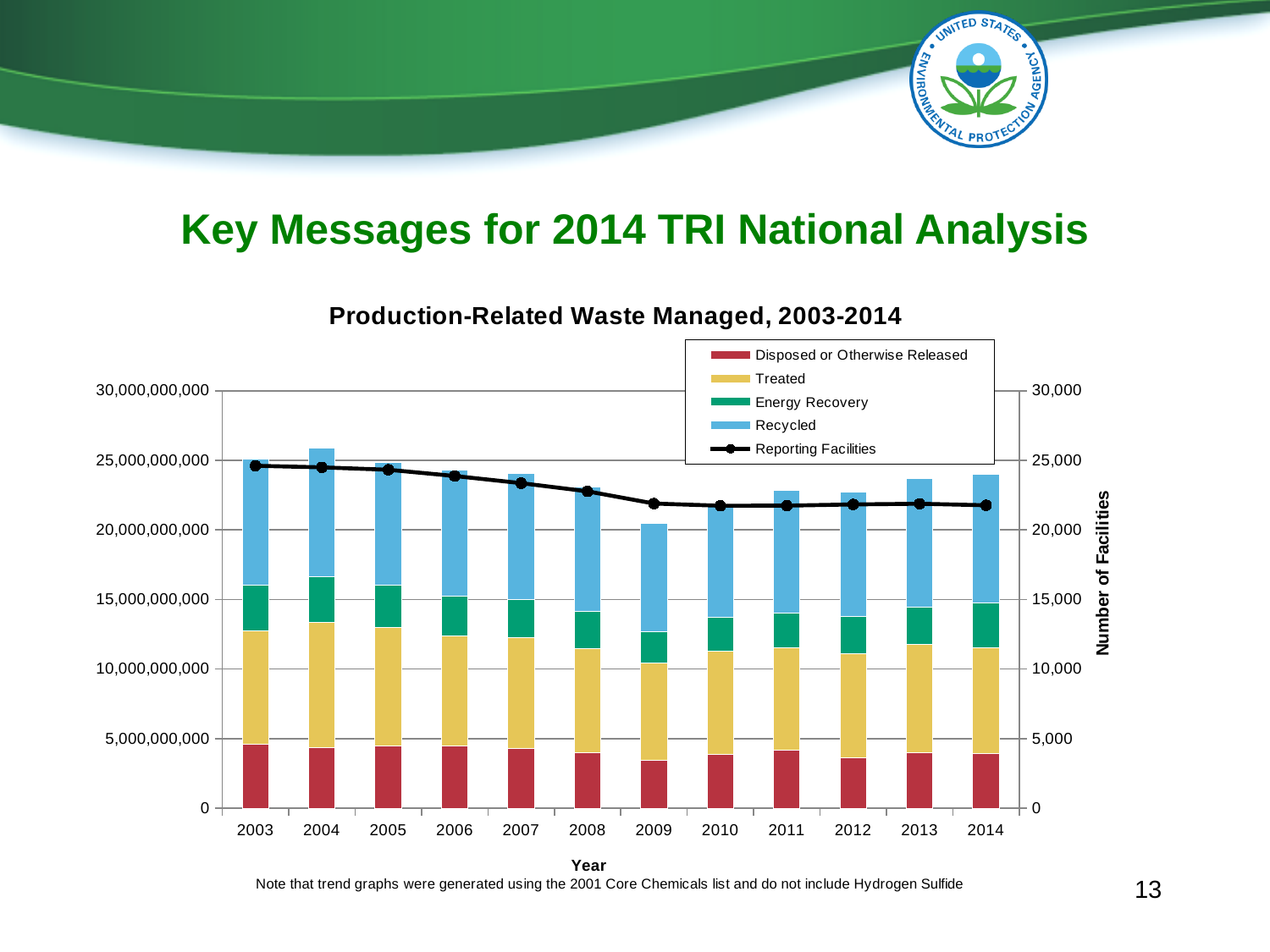
How many years are shown on the x axis of the chart? 12 Does the Reporting Facilities line rise or fall from 2003 to 2010? fall Which year has the shortest stacked bar for production-related waste managed? 2009 Is the number of reporting facilities in 2014 greater or less than 25,000? less Which year has the tallest stacked bar for production-related waste managed? 2004 Is the total stacked bar for 2004 greater or less than 25,000,000,000? greater What is the title of the chart? Production-Related Waste Managed, 2003-2014 How many series does the legend list? 5 Which is larger in 2003, the Treated segment or the Energy Recovery segment? Treated What is the label of the right-hand vertical axis? Number of Facilities Is the total stacked bar for 2009 greater or less than 25,000,000,000? less What kind of chart is shown on the slide? Stacked bar chart with a line